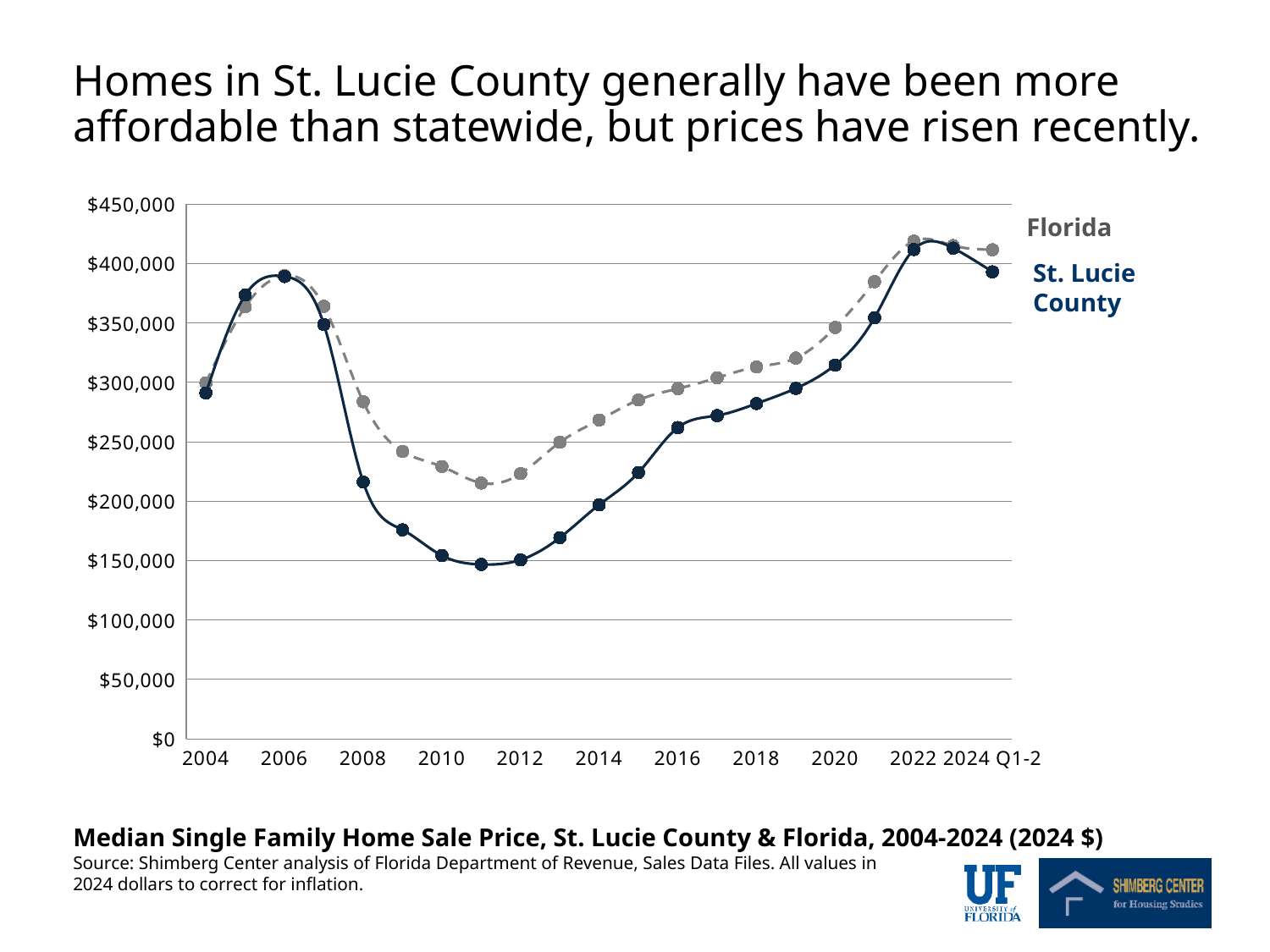
How many series does the chart show? 2 Is the St. Lucie County value for 2008 greater or less than $200,000? greater In which year does the St. Lucie County line reach its lowest value? 2011 How many yearly data points does each line have? 21 In 2008, which series has the higher value, Florida or St. Lucie County? Florida Does the St. Lucie County line rise or fall between 2011 and 2022? rise What is the title of the chart? Median Single Family Home Sale Price, St. Lucie County & Florida, 2004-2024 (2024 $) What kind of chart is shown on the slide? line chart Which two series are plotted on the chart? Florida and St. Lucie County Is the Florida value for 2021 greater or less than $350,000? greater In which year does the Florida line reach its lowest value? 2011 Is the St. Lucie County value for 2004 greater or less than $300,000? less